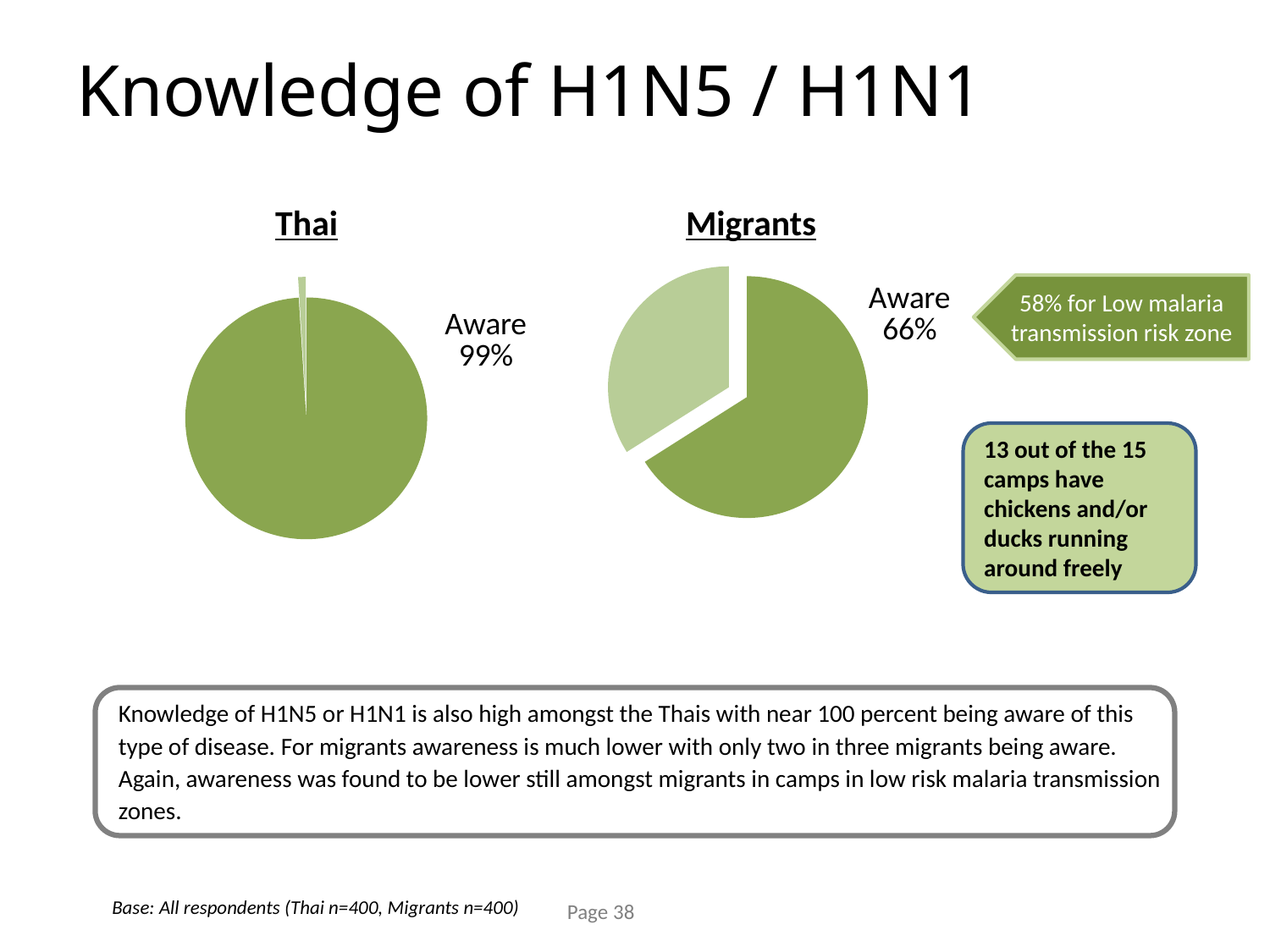
What type of chart is used to show awareness for the Thai group? Pie chart How many pie charts are shown on the slide? 2 In the Migrants pie chart, is the Aware share greater or less than 50%? greater What is the title of the pie chart on the left? Thai In the Migrants pie chart, what share of respondents are aware of H1N5 / H1N1? 66% How many slices does the Thai pie chart have? 2 In the Thai pie chart, what share of respondents are aware of H1N5 / H1N1? 99% How many slices does the Migrants pie chart have? 2 What type of chart is used to show awareness for the Migrants group? Pie chart What is the title of the pie chart on the right? Migrants What is the difference in percentage points between the Aware share in the Thai chart and the Aware share in the Migrants chart? 33 percentage points Which group has the higher share of respondents aware of H1N5 / H1N1, Thai or Migrants? Thai